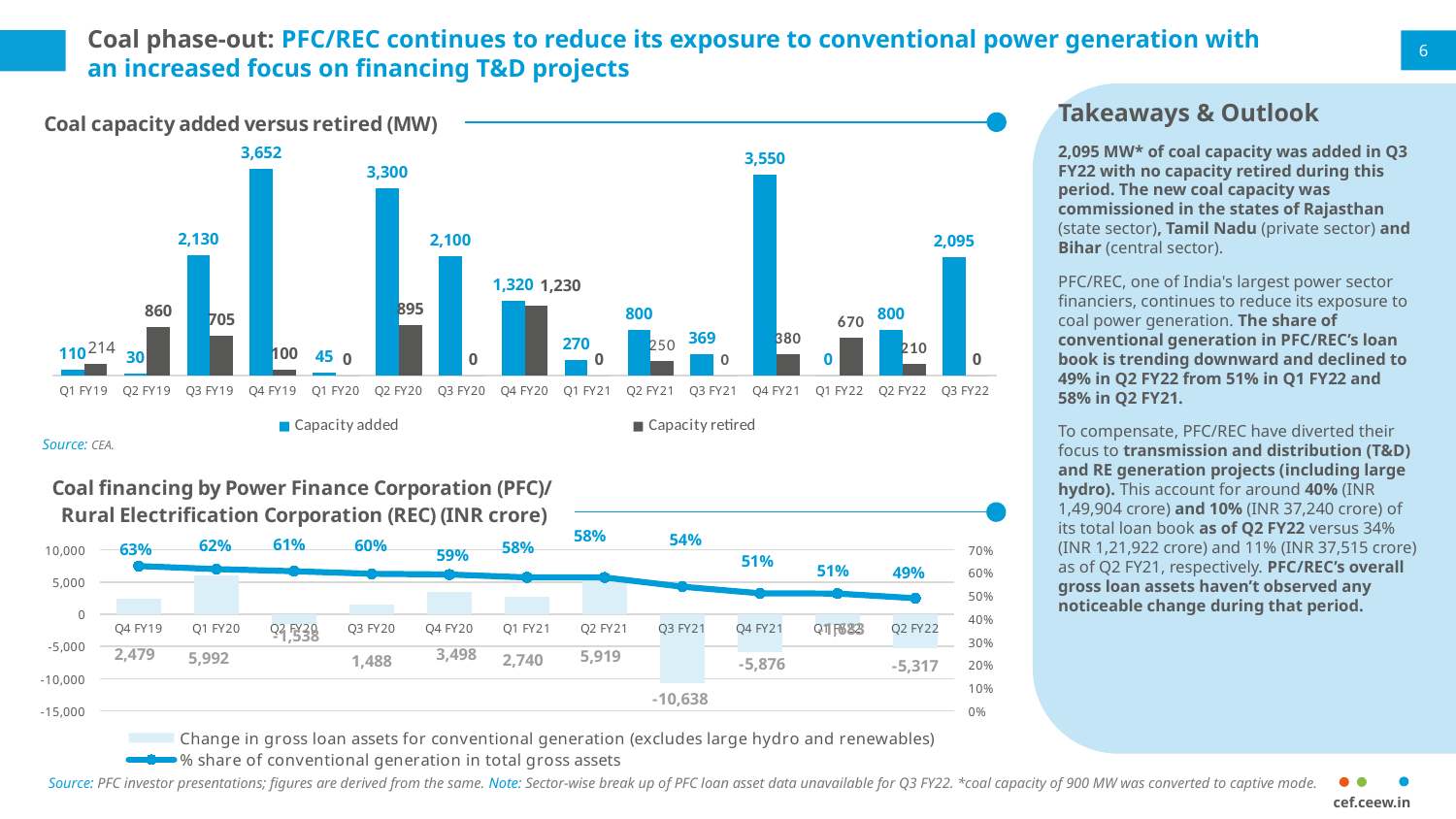
In the 'Coal capacity added versus retired (MW)' chart, which quarter had the highest capacity retired? Q4 FY20 In the 'Coal financing by PFC/REC (INR crore)' chart, does the % share of conventional generation rise or fall from Q4 FY19 to Q2 FY22? Fall In the 'Coal capacity added versus retired (MW)' chart, which quarter had the highest capacity added? Q4 FY19 How many quarters are shown on the x axis of the 'Coal capacity added versus retired (MW)' chart? 15 In the 'Coal financing by PFC/REC (INR crore)' chart, what was the change in gross loan assets for conventional generation in Q3 FY21? -10,638 In the 'Coal financing by PFC/REC (INR crore)' chart, what was the % share of conventional generation in total gross assets in Q2 FY22? 49% In the 'Coal capacity added versus retired (MW)' chart, was more capacity added or retired in Q2 FY19? Retired In the 'Coal capacity added versus retired (MW)' chart, what is the difference between capacity added and capacity retired in Q4 FY21? 3,170 In the 'Coal financing by PFC/REC (INR crore)' chart, what is the difference in % share of conventional generation between Q4 FY19 and Q2 FY22? 14 percentage points In the 'Coal capacity added versus retired (MW)' chart, what was the capacity retired in Q4 FY20? 1,230 How many series does the legend of the 'Coal capacity added versus retired (MW)' chart list? 2 In the 'Coal capacity added versus retired (MW)' chart, what was the capacity added in Q3 FY22? 2,095